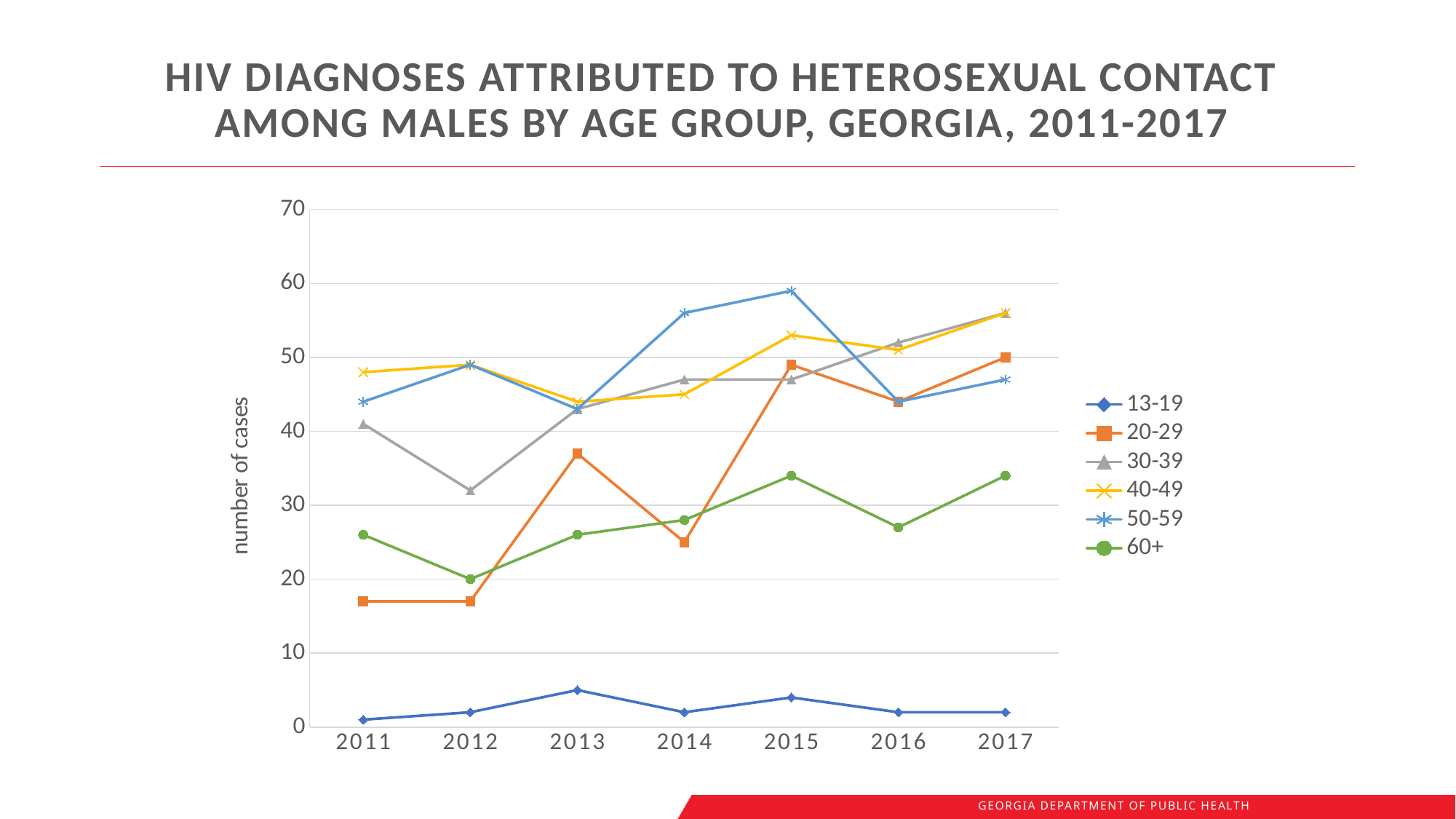
What type of chart is shown on the slide? line chart Is the value for the 20-29 age group in 2011 greater or less than 20? less Is the value for the 13-19 age group in 2013 greater or less than 10? less Which age group has the highest number of cases in 2015? 50-59 Which is larger for the 20-29 age group: the value in 2013 or the value in 2014? 2013 Is the value for the 50-59 age group in 2015 greater or less than 50? greater Which age group has the lowest number of cases in every year shown? 13-19 In which year does the 50-59 age group reach its highest number of cases? 2015 How many age groups does the legend list? 6 In which year does the 30-39 age group have its lowest number of cases? 2012 What is the label on the y axis? number of cases How many years are shown on the x axis? 7